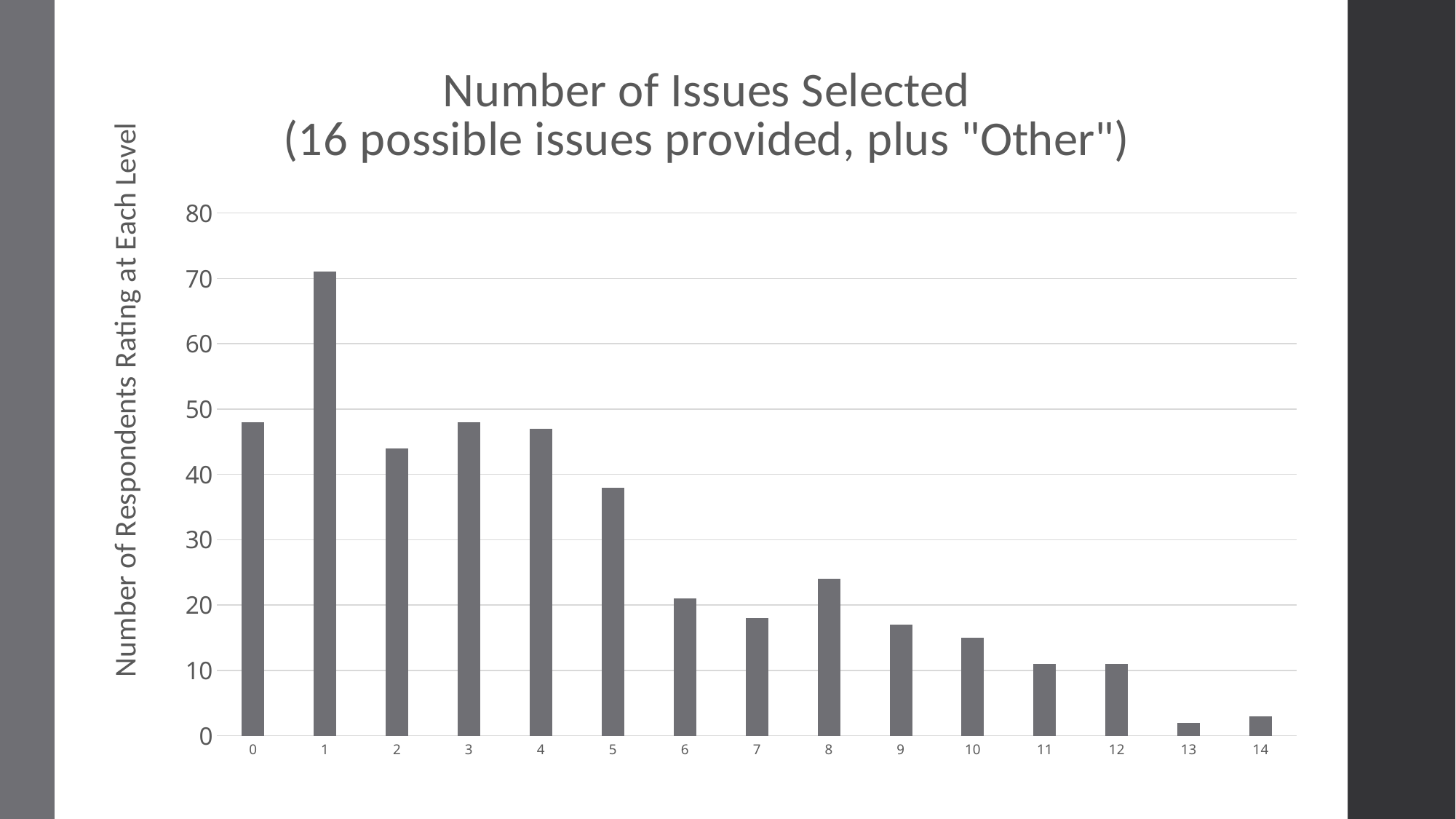
What is the title of the chart? Number of Issues Selected (16 possible issues provided, plus "Other") Is the value for 11 issues selected greater or less than 20? less Which has more respondents: 1 issue selected or 0 issues selected? 1 Is the value for 8 issues selected greater or less than 20? greater Do the values generally rise or fall from 1 issue selected to 14 issues selected? fall Is the value for 13 issues selected greater or less than 10? less Which number of issues selected has the highest number of respondents? 1 What kind of chart is shown on the slide? bar chart Which has more respondents: 5 issues selected or 6 issues selected? 5 What is the label on the vertical axis? Number of Respondents Rating at Each Level How many categories (number of issues selected) are shown on the x axis? 15